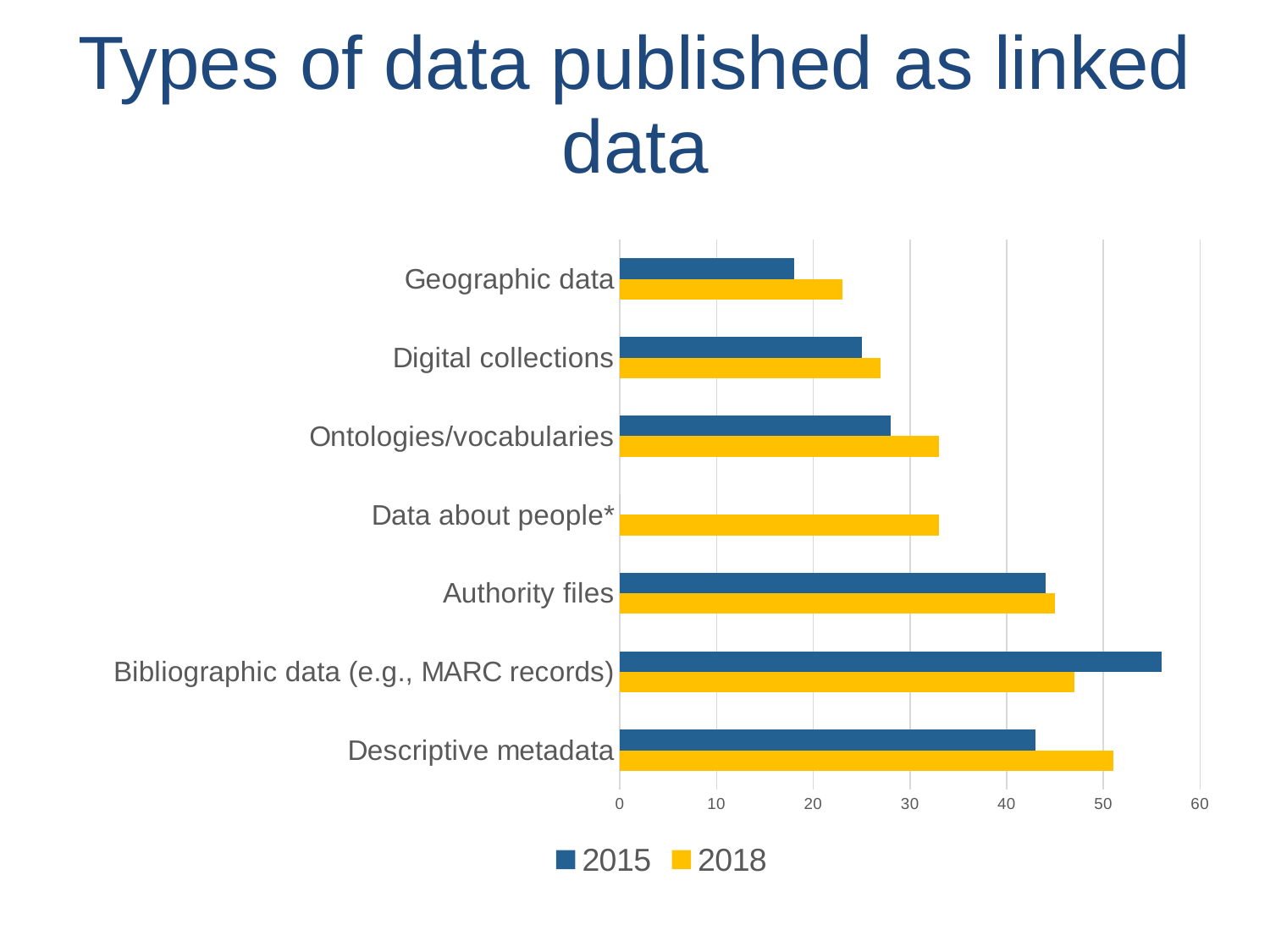
Which category has the highest value for 2018? Descriptive metadata Is the 2015 value for Bibliographic data (e.g., MARC records) greater or less than 50? greater How many series does the legend list? 2 How many categories of data are listed on the chart? 7 Is the 2018 value for Geographic data greater or less than 30? less Which category has a bar for 2018 only and no bar for 2015? Data about people* What kind of chart is shown on the slide? bar chart For Bibliographic data (e.g., MARC records), which year has the larger value, 2015 or 2018? 2015 For Descriptive metadata, which year has the larger value, 2015 or 2018? 2018 Which category has the highest value for 2015? Bibliographic data (e.g., MARC records) Which category has the lowest value for 2018? Geographic data